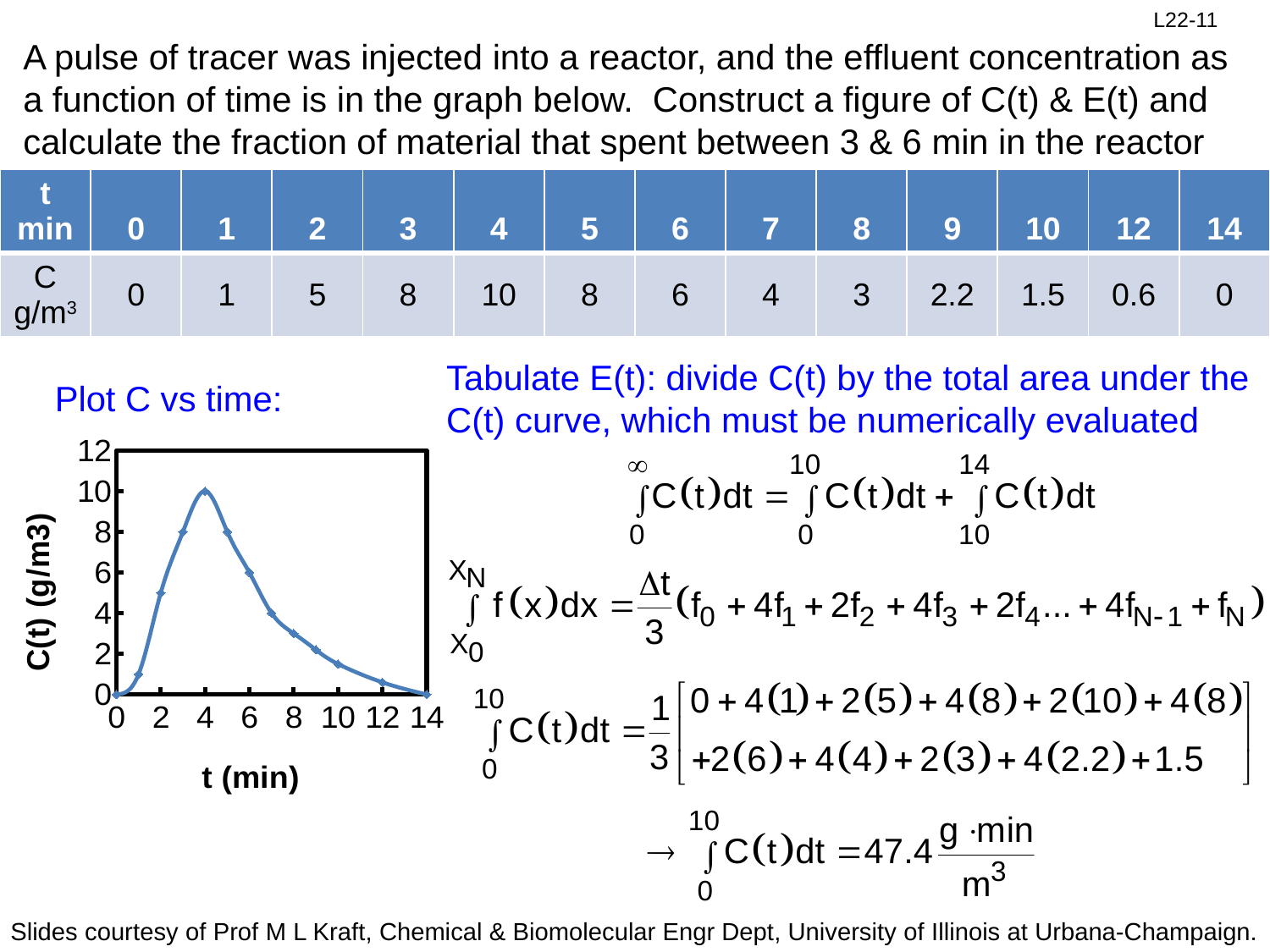
In the C vs time chart, which is larger: C(t) at t = 5 min or C(t) at t = 7 min? t = 5 min In the C vs time chart, what is the value of C(t) at t = 3 min? 8 In the C vs time chart, what is the difference between C(t) at t = 4 min and C(t) at t = 6 min? 4 In the C vs time chart, at what time (min) does C(t) reach its maximum? 4 What is the label of the x axis of the C vs time chart? t (min) In the C vs time chart, how does C(t) change as t increases from 4 min to 14 min? it falls How many data points are plotted in the C vs time chart? 13 In the C vs time chart, is the value of C(t) at t = 2 min greater or less than 4? greater In the C vs time chart, what is the value of C(t) at t = 9 min? 2.2 In the C vs time chart, is the value of C(t) at t = 10 min greater or less than 2? less In the C vs time chart, what is the maximum value of C(t) in g/m3? 10 What kind of chart is the 'Plot C vs time' chart? line chart